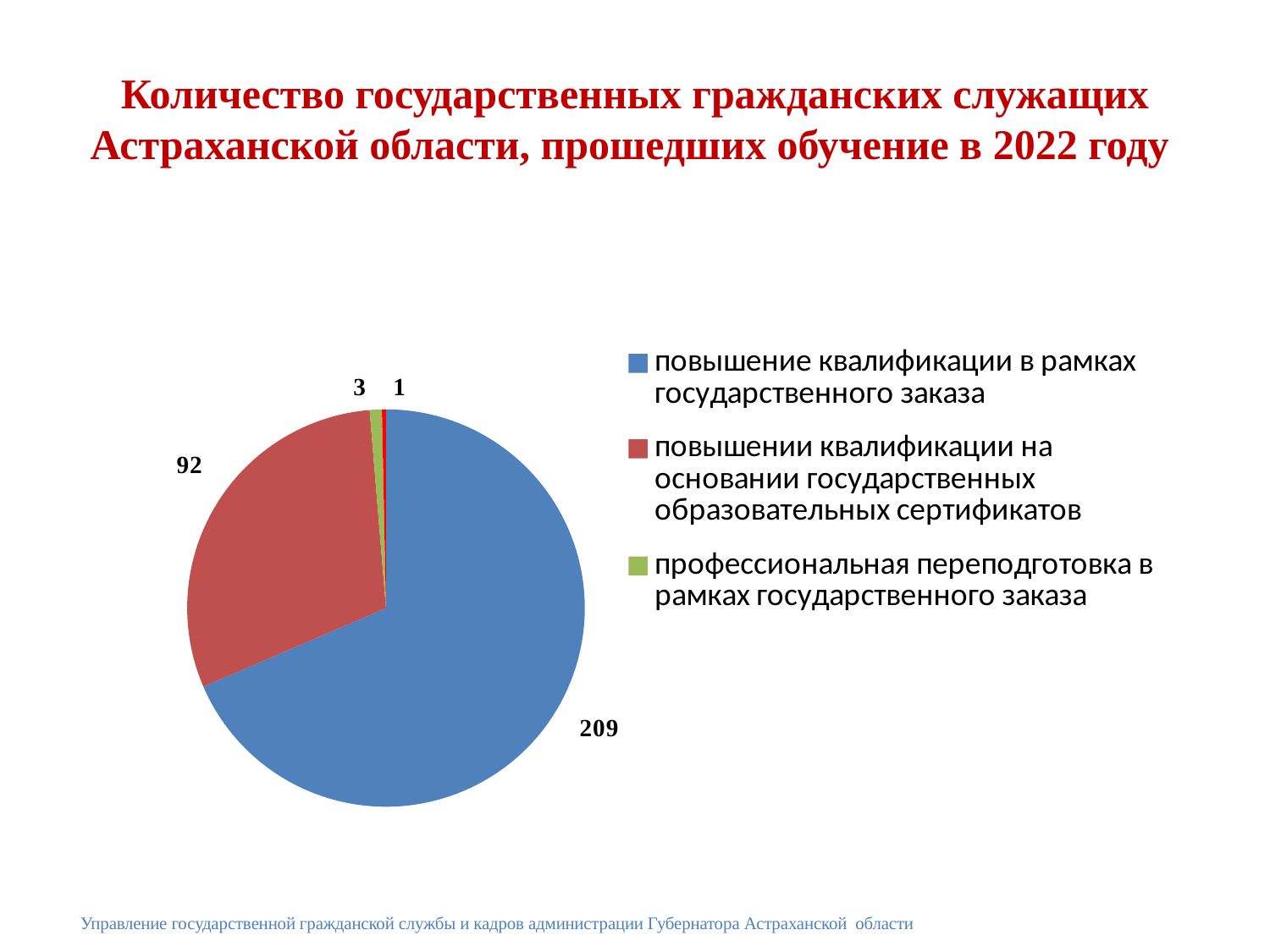
What is the difference between the value for повышение квалификации в рамках государственного заказа and the value for повышении квалификации на основании государственных образовательных сертификатов? 117 What is the total of all the values labelled on the pie chart? 305 How many entries does the legend list? 3 What is the value for профессиональная переподготовка в рамках государственного заказа? 3 What is the value for повышении квалификации на основании государственных образовательных сертификатов? 92 How many civil servants completed повышение квалификации в рамках государственного заказа? 209 How many data labels are shown on the pie chart? 4 Which is larger: the blue slice or the red slice? the blue slice By how much does the value for повышении квалификации на основании государственных образовательных сертификатов exceed the value for профессиональная переподготовка в рамках государственного заказа? 89 Which category has the largest slice of the pie? повышение квалификации в рамках государственного заказа What type of chart is shown on the slide? pie chart What is the smallest value labelled on the pie chart? 1